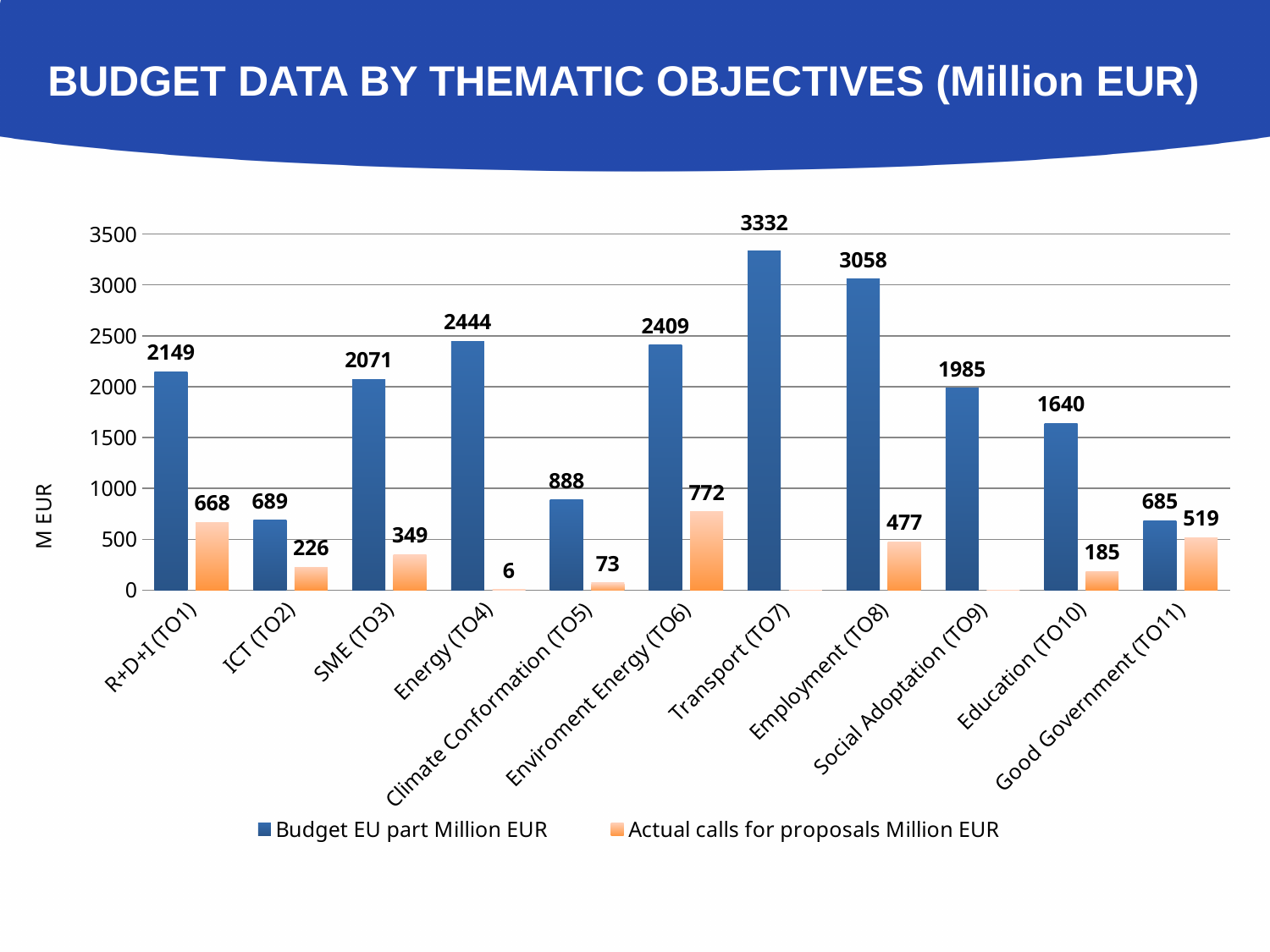
What kind of chart is shown on the slide? Bar chart Is the Budget EU part value for Social Adoptation (TO9) greater or less than 2000? less What is the Actual calls for proposals value for Energy (TO4)? 6 What is the difference between the Budget EU part and the Actual calls for proposals for R+D+I (TO1)? 1481 What is the Budget EU part value for Transport (TO7)? 3332 Which is larger: the Budget EU part for Energy (TO4) or for Enviroment Energy (TO6)? Energy (TO4) What is the difference between the Budget EU part values for Transport (TO7) and Employment (TO8)? 274 What is the Actual calls for proposals value for Enviroment Energy (TO6)? 772 Which thematic objective has the highest Budget EU part value? Transport (TO7) How many series does the legend list? 2 How many thematic objectives are shown on the x axis? 11 Which thematic objective has the lowest Actual calls for proposals value among those with a labelled value? Energy (TO4)